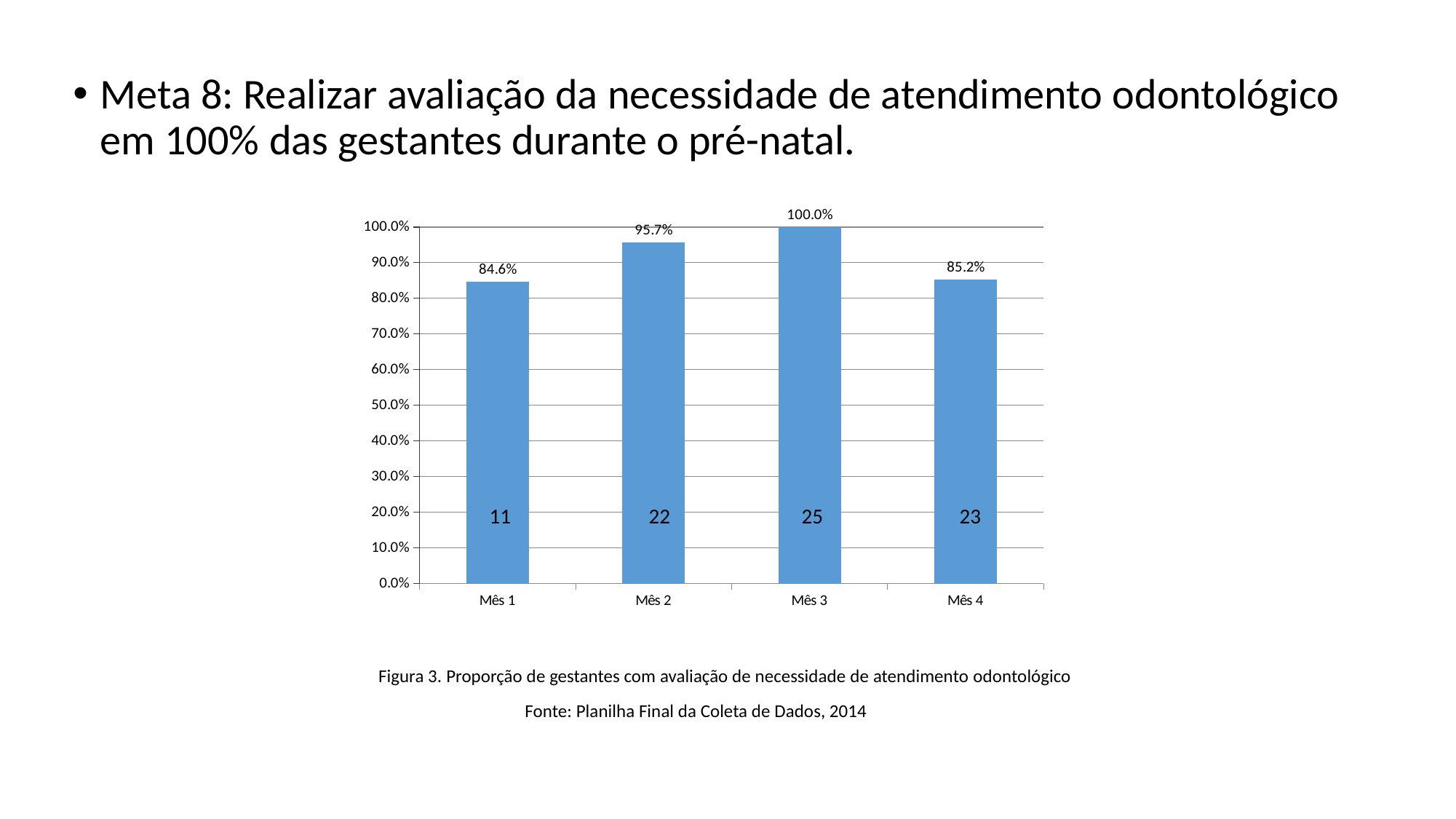
What number is printed inside the bar for Mês 1? 11 What is the difference in percentage points between Mês 3 and Mês 1? 15.4 What number is printed inside the bar for Mês 3? 25 Which is larger, the percentage for Mês 2 or for Mês 4? Mês 2 Is the value for Mês 1 greater or less than 90.0%? less What is the percentage value shown for Mês 4? 85.2% What is the percentage value shown for Mês 2? 95.7% How many months are shown on the x axis? 4 What kind of chart is shown on the slide? bar chart Which month has the highest percentage? Mês 3 Which month has the lowest percentage? Mês 1 What is the figure caption below the chart? Figura 3. Proporção de gestantes com avaliação de necessidade de atendimento odontológico